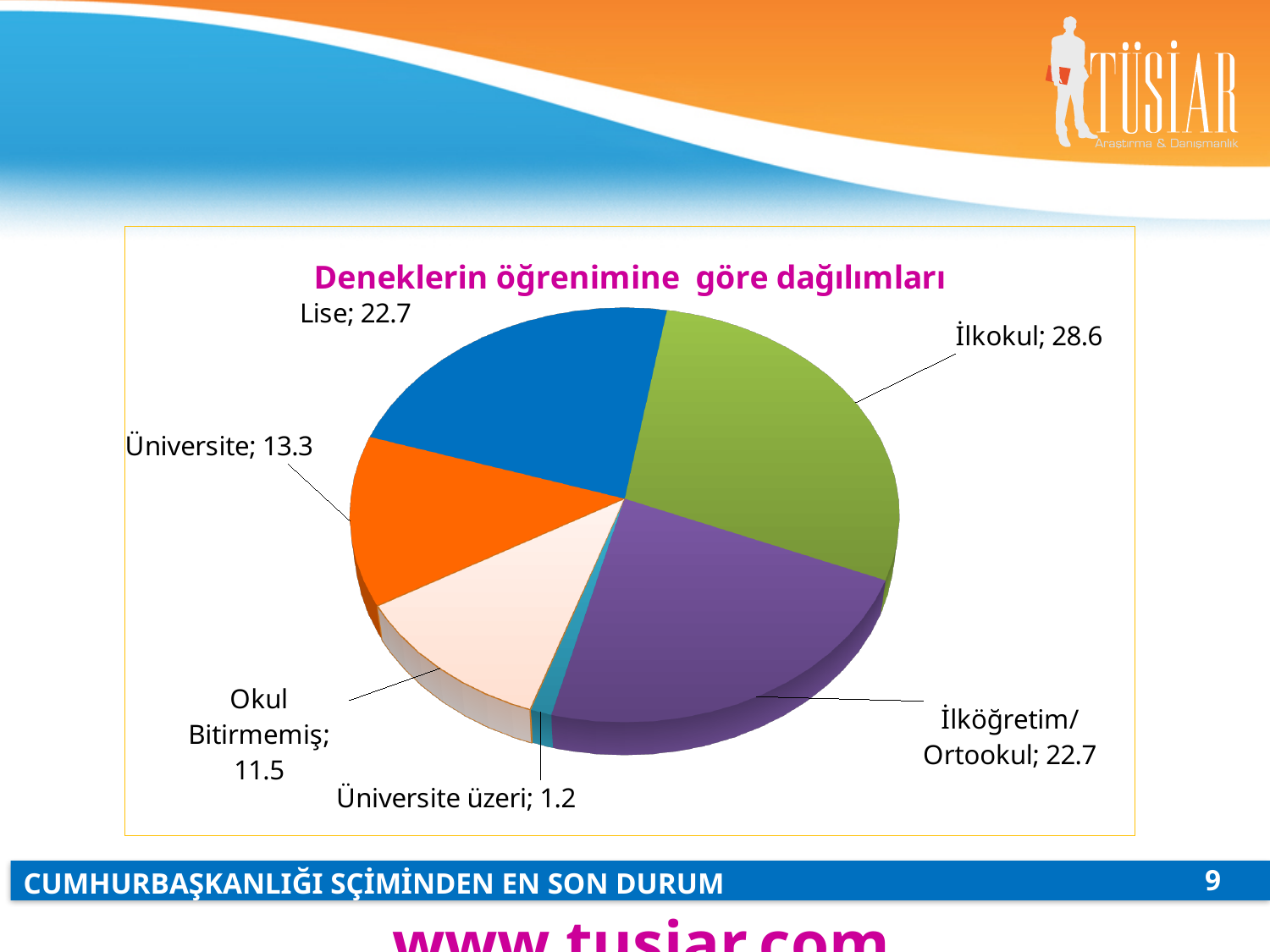
What is the title of the chart? Deneklerin öğrenimine göre dağılımları What is the value for Üniversite? 13.3 Which category has the largest slice? İlkokul What is the value for Okul Bitirmemiş? 11.5 What is the difference between the values for Üniversite and Üniversite üzeri? 12.1 How many categories are shown in the pie chart? 6 What is the value for Üniversite üzeri? 1.2 What type of chart is shown on the slide? pie chart Which category has the smallest slice? Üniversite üzeri What is the difference between the values for İlkokul and Lise? 5.9 Which is larger, the value for Üniversite or the value for Okul Bitirmemiş? Üniversite What is the value for İlkokul? 28.6